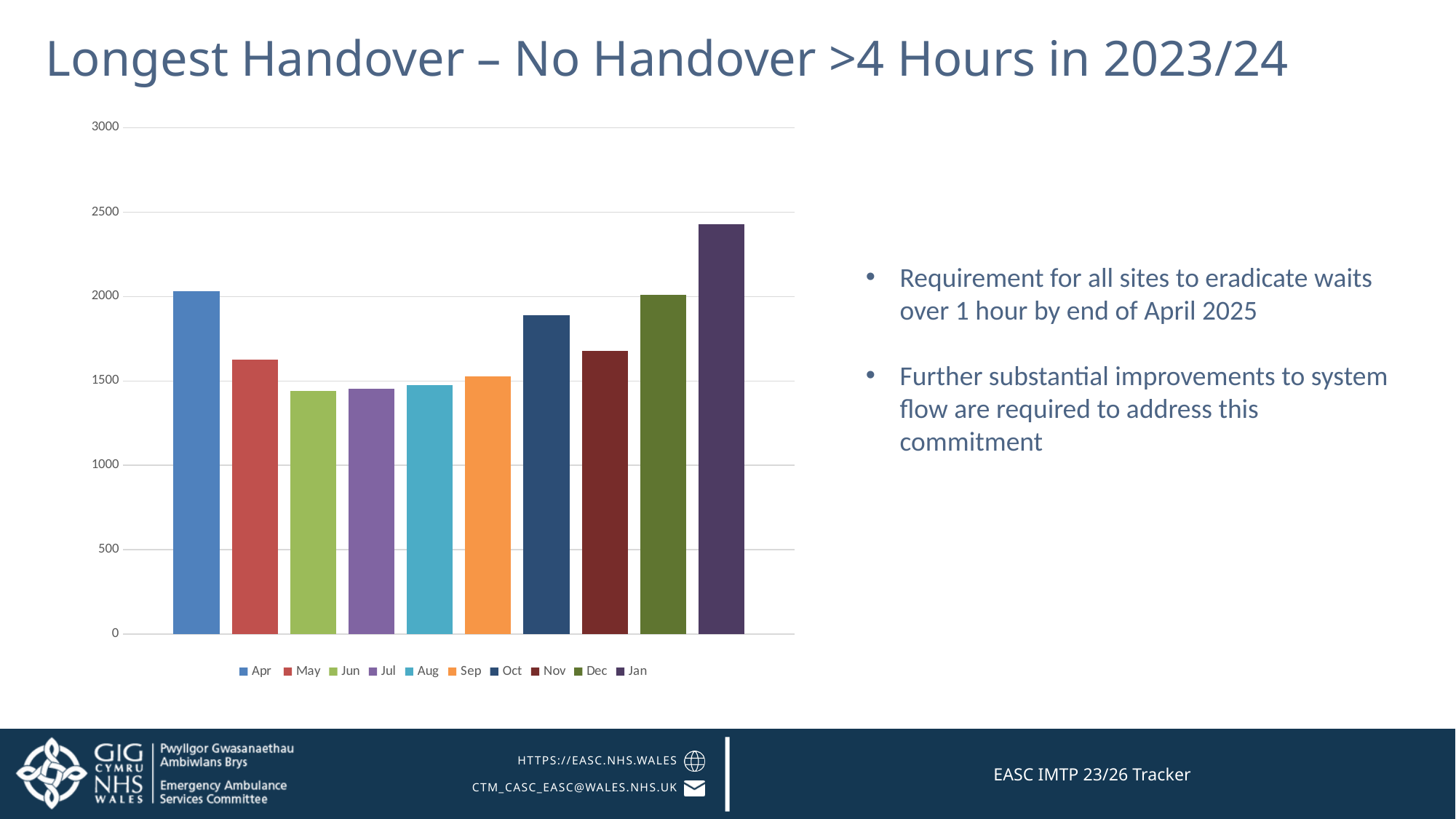
Is the value for Jan greater or less than 2000? greater What is the title of the slide containing the chart? Longest Handover – No Handover >4 Hours in 2023/24 What kind of chart is shown on the slide? bar chart Which month has the highest bar in the chart? Jan How many entries does the chart legend list? 10 Is the value for Nov greater or less than 1500? greater Is the value for Jun greater or less than 1500? less How many bars are plotted in the chart? 10 Which is larger, the value for Oct or the value for Nov? Oct Which is larger, the value for Dec or the value for Oct? Dec